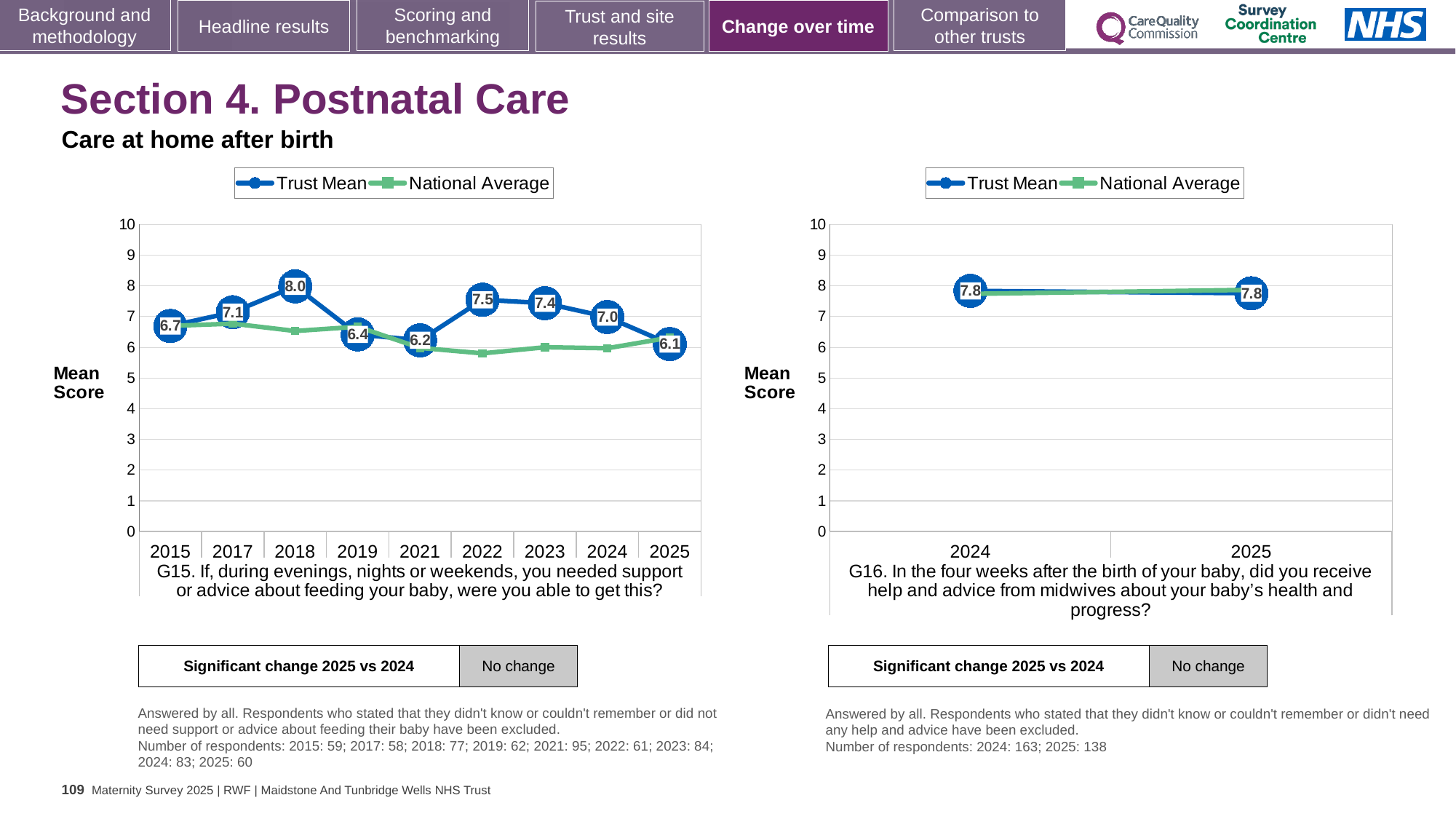
In the G15 chart on the left, which year has the lowest Trust Mean score? 2025 In the G15 chart on the left, what is the difference between the Trust Mean scores for 2018 and 2019? 1.6 How many years are shown on the x axis of the G15 chart on the left? 9 In the G16 chart on the right, what is the Trust Mean score for 2025? 7.8 In the G15 chart on the left, which year has the highest Trust Mean score? 2018 In the G15 chart on the left, is the Trust Mean score higher in 2022 or in 2024? 2022 In the G15 chart on the left, is the National Average for 2022 greater or less than 6? less What type of chart is the G15 chart on the left? line chart How many series does the legend of the G16 chart on the right list? 2 In the G15 chart on the left, what is the Trust Mean score for 2018? 8.0 In the G16 chart on the right, does the Trust Mean rise, fall or stay the same from 2024 to 2025? stays the same In the G15 chart on the left, what is the Trust Mean score for 2025? 6.1